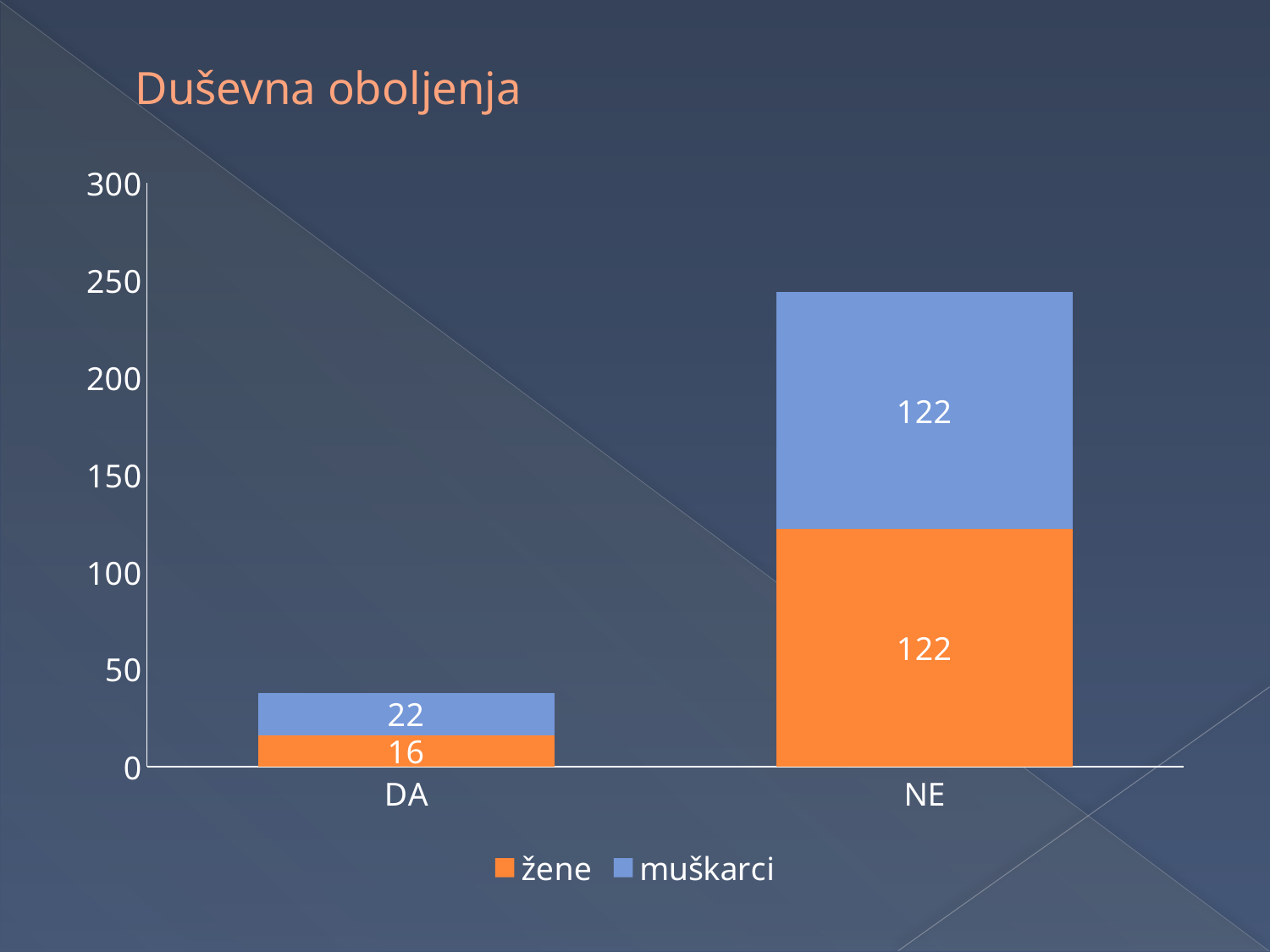
What is the difference between the žene values for NE and DA? 106 What is the total of the stacked bar for DA? 38 What kind of chart is shown on the slide? Stacked bar chart How many categories are shown on the x axis? 2 What is the value for muškarci in the NE category? 122 What is the value for žene in the NE category? 122 How many series does the legend list? 2 What is the total of the stacked bar for NE? 244 Which category has the lowest value for žene? DA Which category has the higher value for muškarci, DA or NE? NE What is the value for muškarci in the DA category? 22 What is the value for žene in the DA category? 16